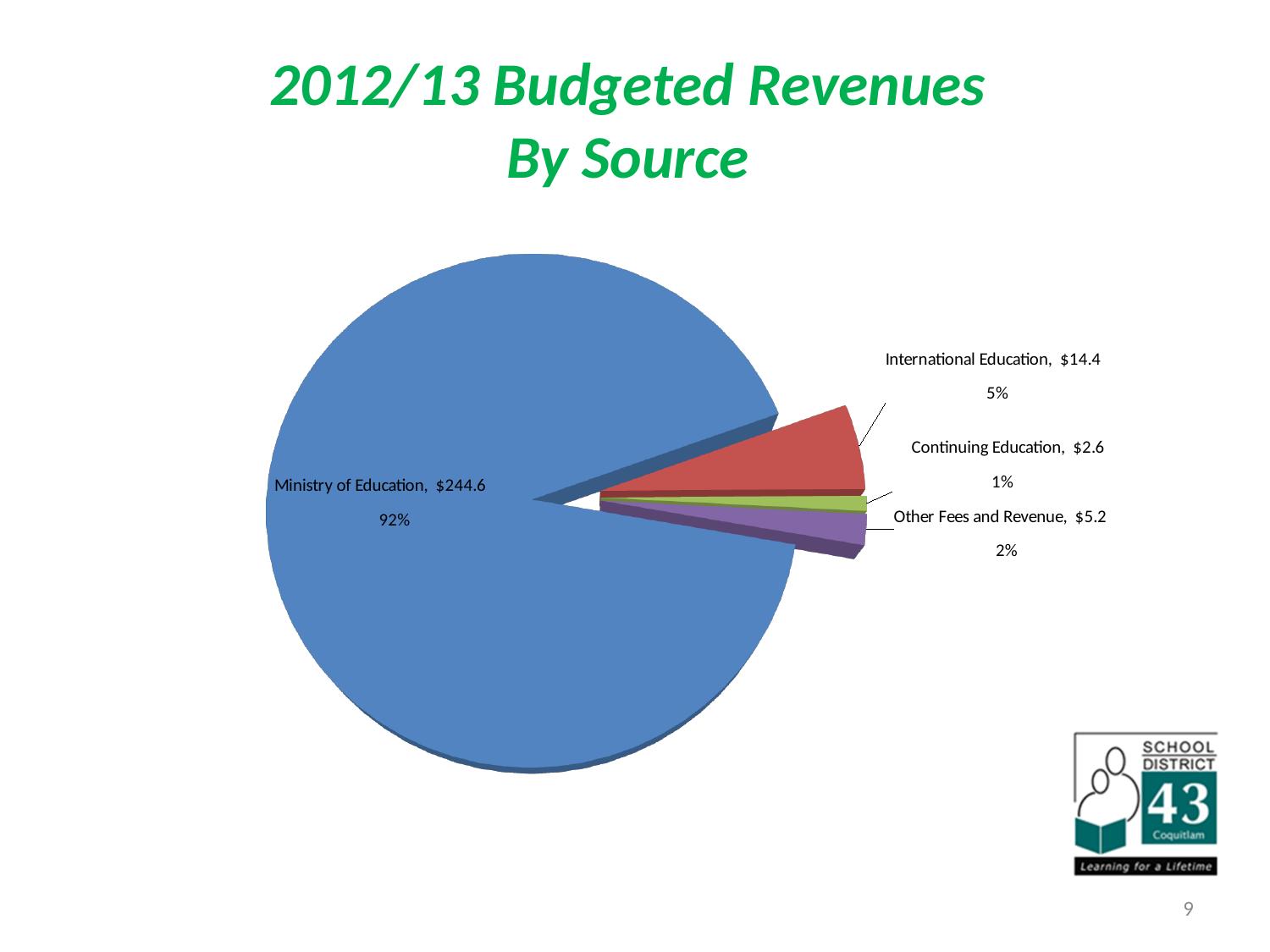
How many revenue sources are shown in the pie chart? 4 Which revenue source is the largest? Ministry of Education What share of budgeted revenues comes from the Ministry of Education? 92% Which revenue source is the smallest? Continuing Education What is the budgeted revenue from International Education? $14.4 What is the budgeted revenue from Other Fees and Revenue? $5.2 Which is larger, Other Fees and Revenue or Continuing Education? Other Fees and Revenue What type of chart is shown on the slide? Pie chart What share of budgeted revenues comes from International Education? 5% What is the difference between the International Education and Other Fees and Revenue amounts? $9.2 What is the budgeted revenue from the Ministry of Education? $244.6 What is the budgeted revenue from Continuing Education? $2.6